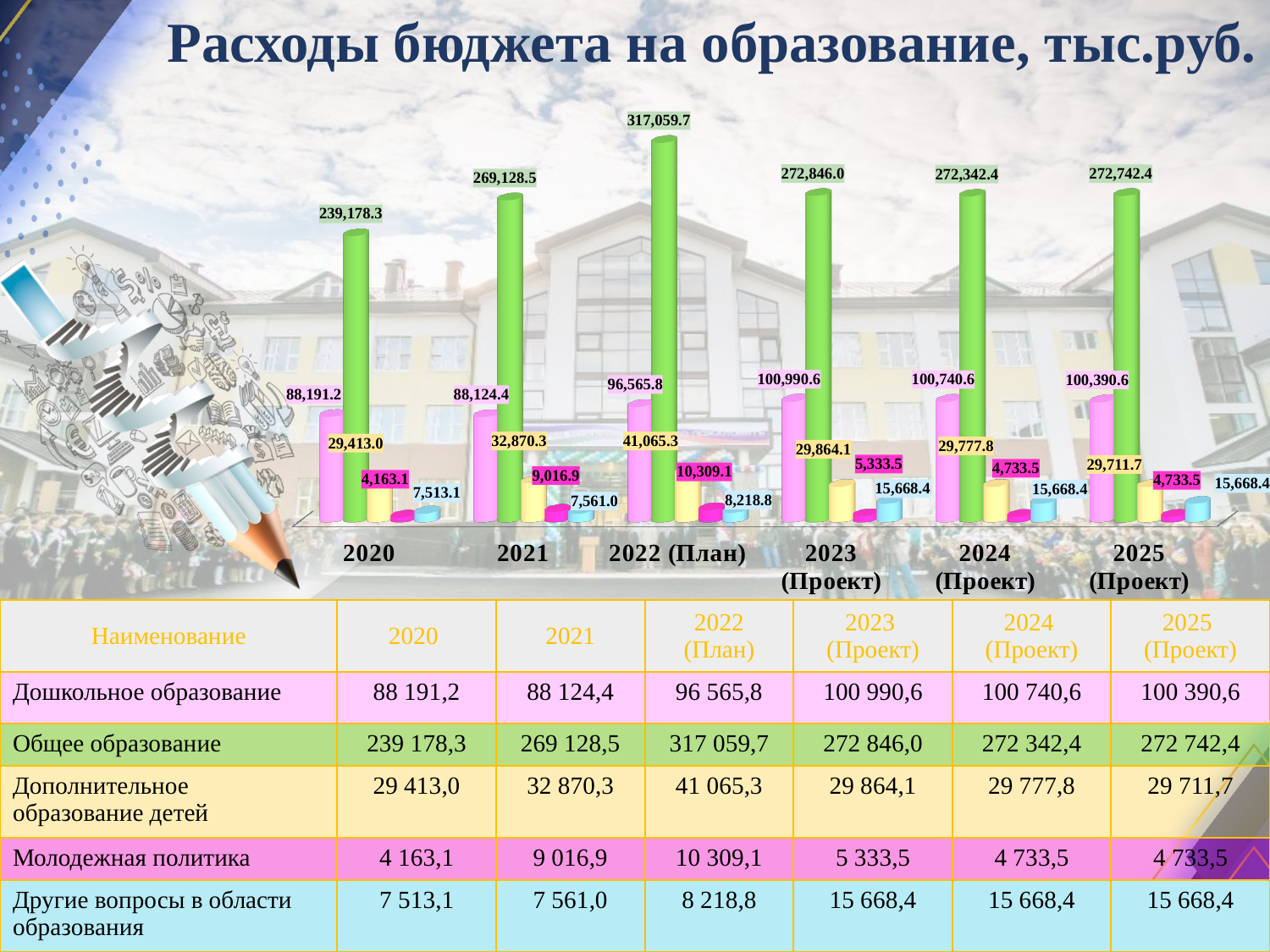
What is the value for Другие вопросы в области образования in 2025 (Проект)? 15,668.4 How many years (categories) are shown on the x axis of the chart? 6 Does the value for Дошкольное образование rise or fall from 2020 to 2023 (Проект)? Rise What is the difference between the Общее образование values for 2021 and 2020? 29,950.2 What is the title of the chart? Расходы бюджета на образование, тыс.руб. What is the value for Общее образование in 2022 (План)? 317,059.7 What is the value for Молодежная политика in 2021? 9,016.9 What is the value for Дошкольное образование in 2023 (Проект)? 100,990.6 Which is larger: Дополнительное образование детей in 2022 (План) or in 2021? 2022 (План) In which year is the value for Общее образование the highest? 2022 (План) In which year is the value for Молодежная политика the lowest? 2020 What kind of chart is shown on the slide? Bar chart